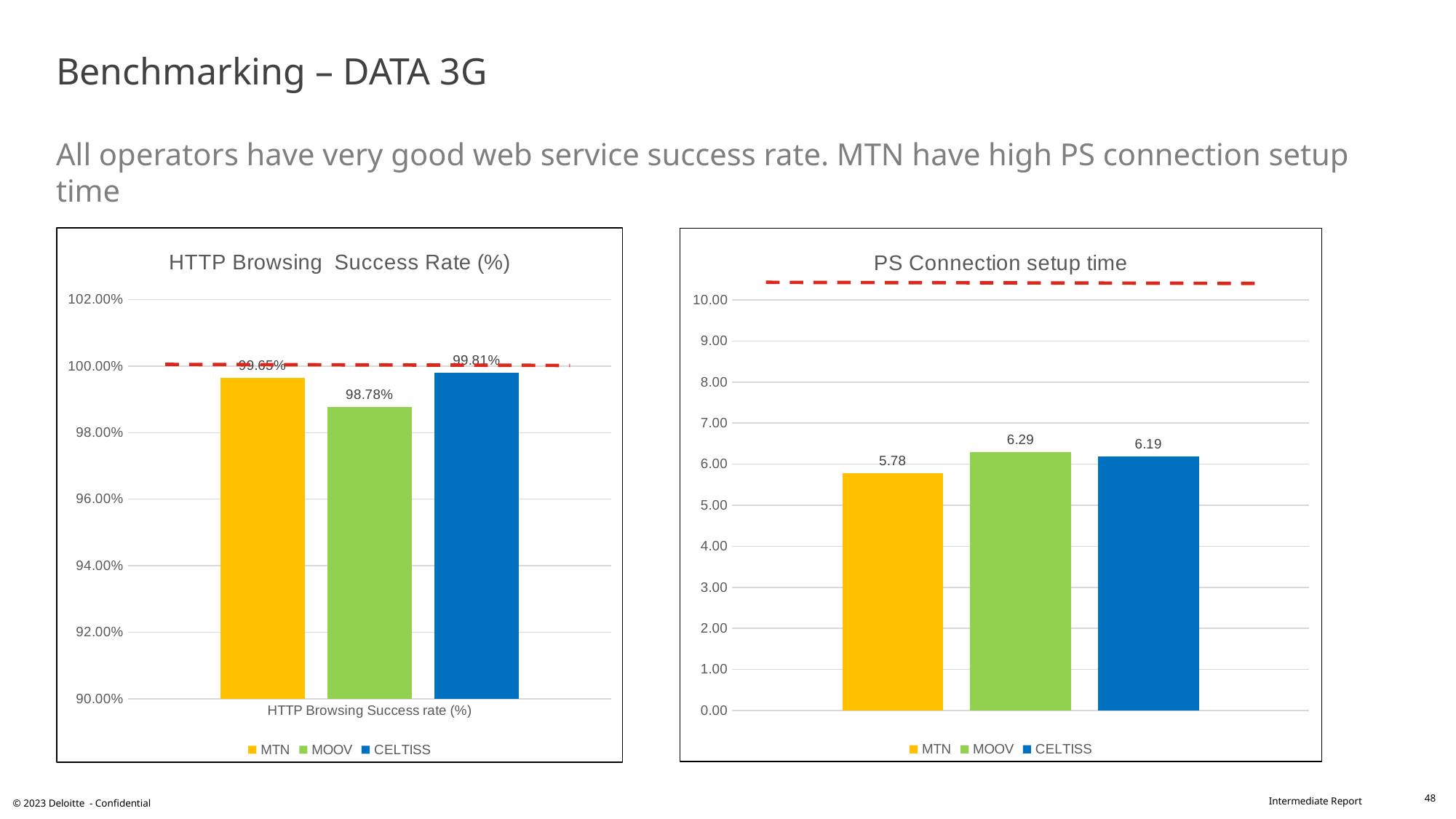
In the PS Connection setup time chart, what is the difference between MOOV and MTN? 0.51 In the PS Connection setup time chart, what is the value for MOOV? 6.29 In the HTTP Browsing Success Rate (%) chart, is the value for MTN greater or less than 98.00%? greater In the HTTP Browsing Success Rate (%) chart, what is the value for CELTISS? 99.81% In the HTTP Browsing Success Rate (%) chart, what is the value for MOOV? 98.78% What kind of chart is the PS Connection setup time chart? Bar chart In the HTTP Browsing Success Rate (%) chart, which operator has the lowest success rate? MOOV In the PS Connection setup time chart, what is the value for MTN? 5.78 In the PS Connection setup time chart, how many series does the legend list? 3 In the PS Connection setup time chart, what is the value for CELTISS? 6.19 In the HTTP Browsing Success Rate (%) chart, what is the difference between CELTISS and MOOV? 1.03% In the PS Connection setup time chart, which operator has the highest setup time? MOOV